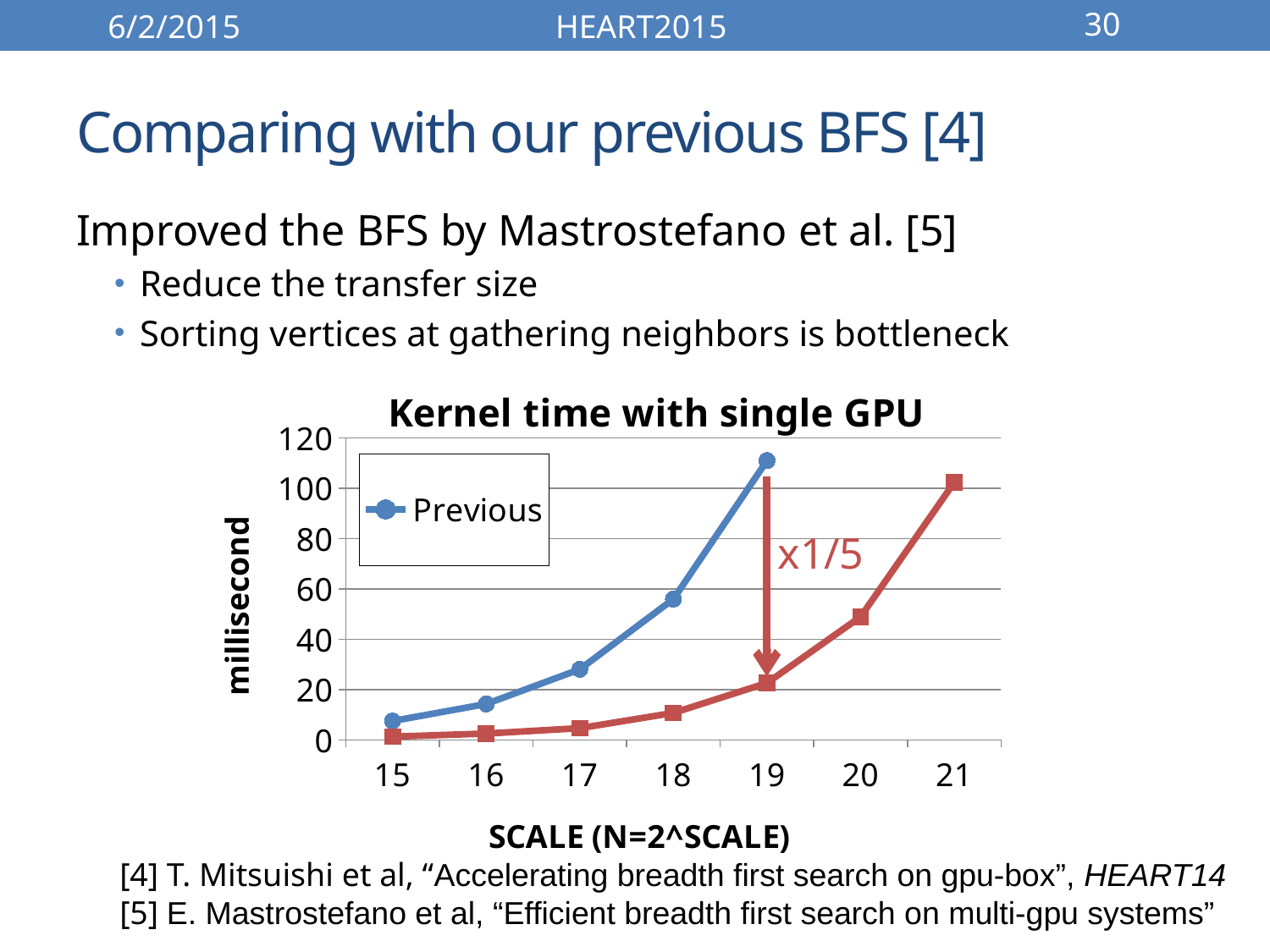
At which SCALE value is the Previous series highest? 19 Does the kernel time of the Previous series rise or fall as SCALE increases? rise How many series does the chart's legend list? 1 Is the value for the Previous series at SCALE 17 greater or less than 20? greater How many data points does the Previous series have? 5 What is the label of the y axis of the chart? millisecond How many SCALE values are marked on the x axis? 7 What is the title of the chart? Kernel time with single GPU At which SCALE value is the Previous series lowest? 15 Is the value for the Previous series at SCALE 19 greater or less than 100? greater What kind of chart is shown on the slide? line chart Is the value for the Previous series at SCALE 18 greater or less than 60? less